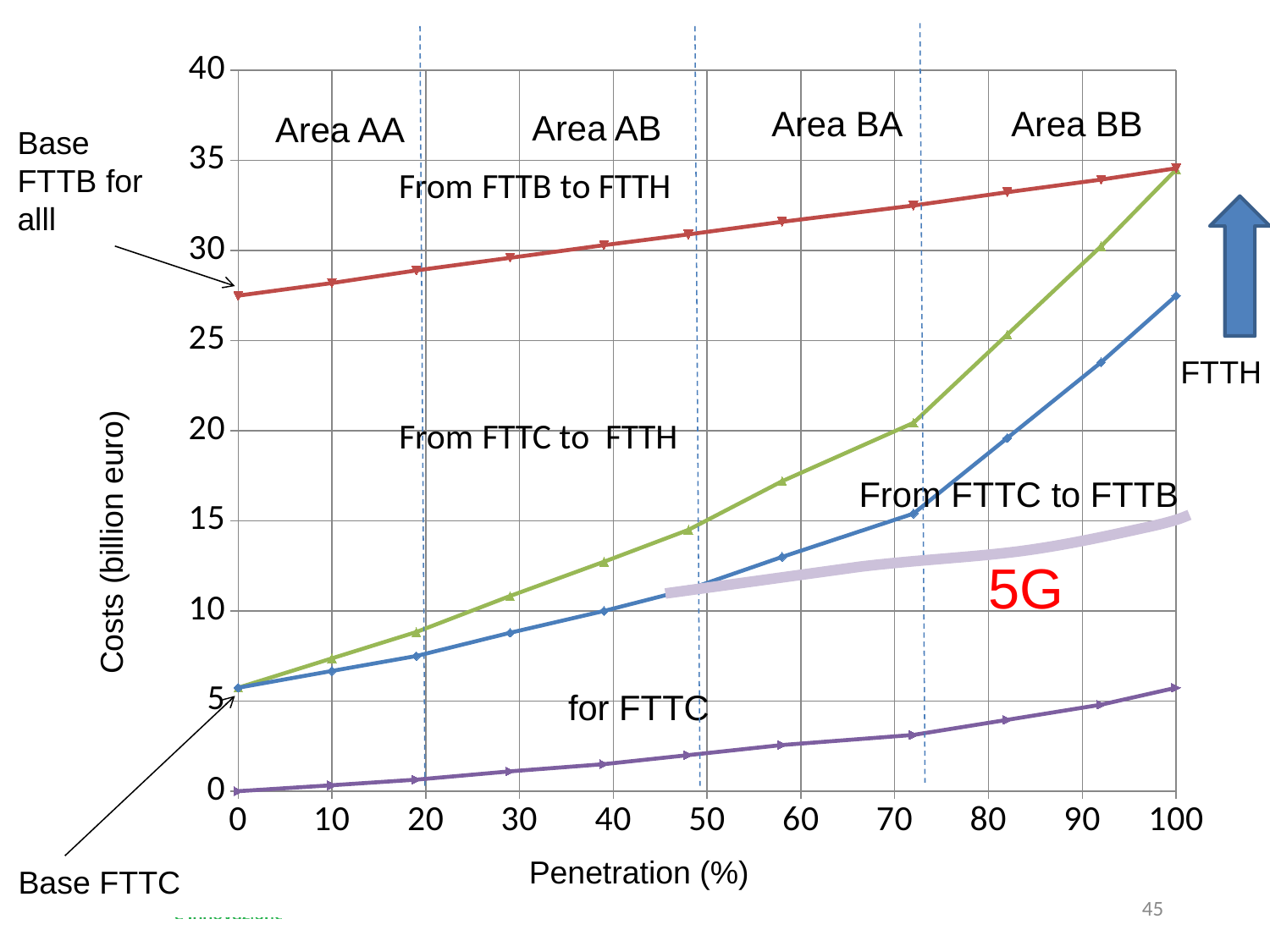
Which line has the highest cost at 0% penetration? From FTTB to FTTH Which line has the lowest cost at 100% penetration? for FTTC Is the cost for 'for FTTC' at 100% penetration greater or less than 10? less Is the cost for 'From FTTB to FTTH' at 0% penetration greater or less than 25? greater Does the cost for 'From FTTC to FTTB' rise or fall as penetration increases? rise What is the title of the y axis? Costs (billion euro) What kind of chart is shown on the slide? line chart Is the cost for 'From FTTC to FTTH' at 100% penetration greater or less than 30? greater How many penetration values are marked on the x axis? 11 At 100% penetration, which is higher: the 'From FTTC to FTTH' line or the 'From FTTC to FTTB' line? From FTTC to FTTH What is the title of the x axis? Penetration (%)